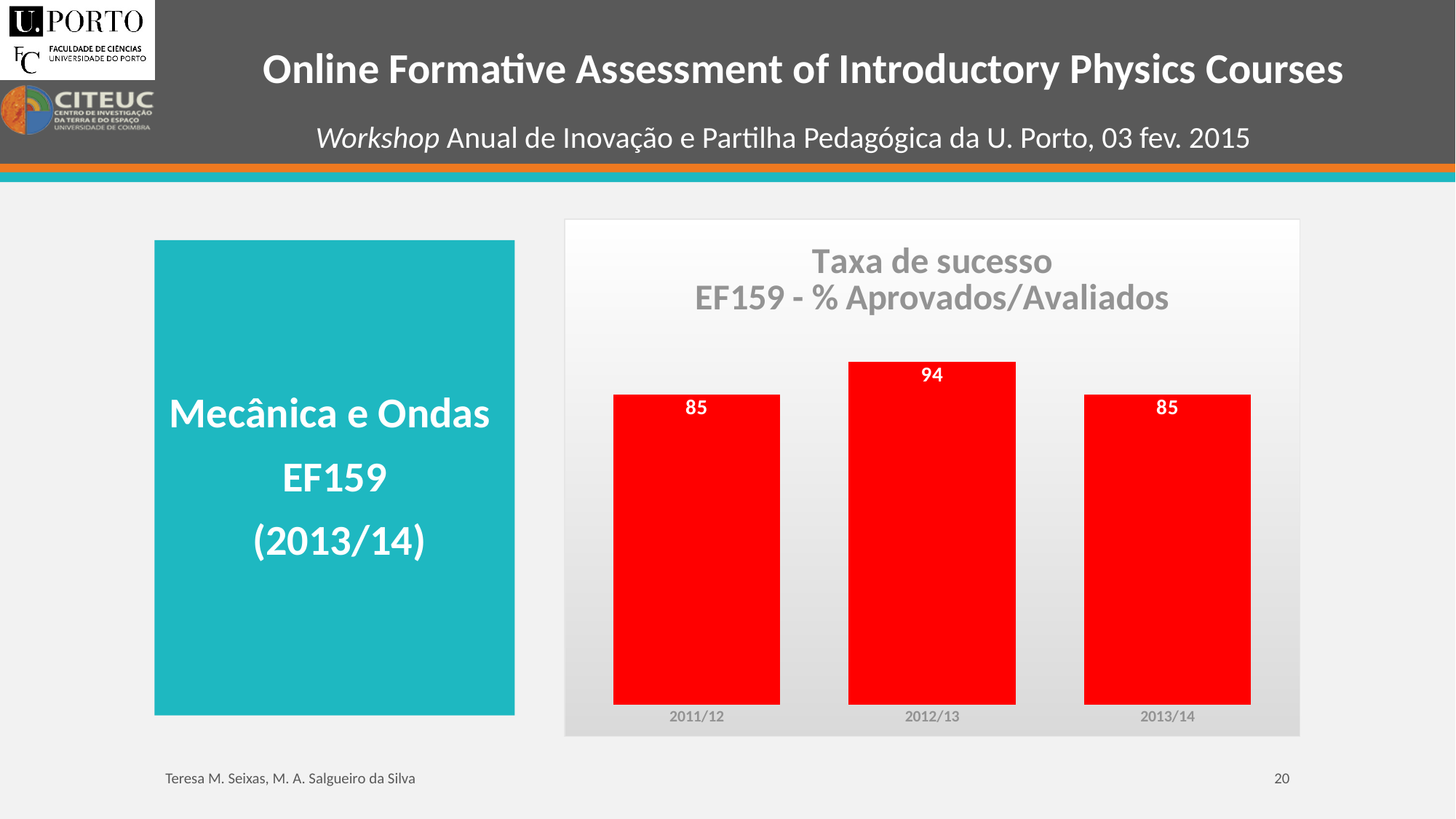
What is the difference between the values for 2012/13 and 2011/12? 9 What is the value for 2011/12? 85 What is the value for 2012/13? 94 Do the values for 2011/12 and 2013/14 differ? No, both are 85 What is the value for 2013/14? 85 Which is larger, the value for 2012/13 or the value for 2013/14? 2012/13 What is the title of the chart? Taxa de sucesso EF159 - % Aprovados/Avaliados What colour are the bars? red What kind of chart is shown? bar chart How many years are shown on the x axis? 3 Which year has the highest value? 2012/13